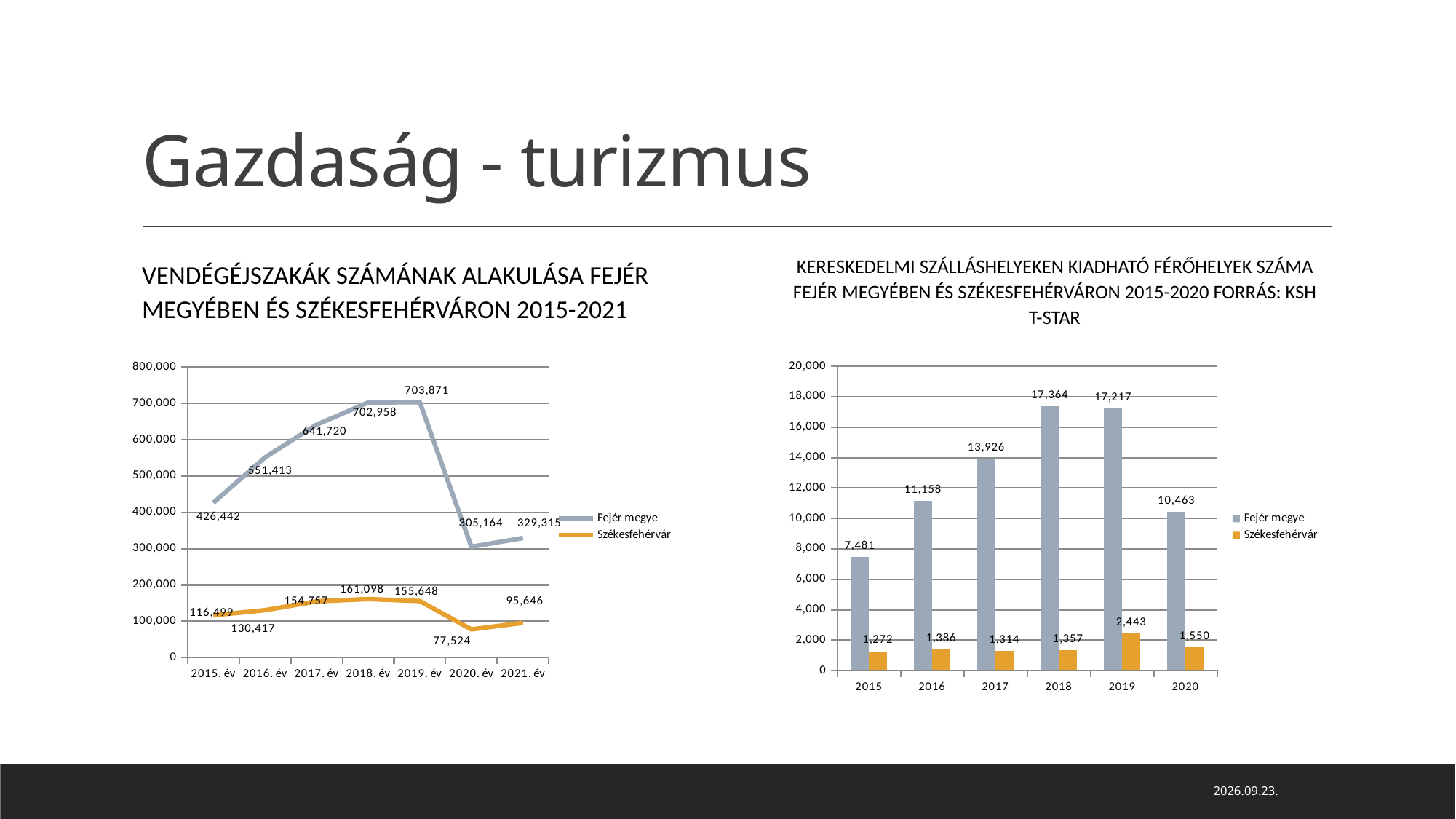
In the right chart (Kereskedelmi szálláshelyeken kiadható férőhelyek száma), what is the difference between the Székesfehérvár values for 2019 and 2018? 1,086 In the right chart (Kereskedelmi szálláshelyeken kiadható férőhelyek száma), what is the Fejér megye value for 2018? 17,364 What kind of chart is the right chart (Kereskedelmi szálláshelyeken kiadható férőhelyek száma)? Bar chart In the left chart (Vendégéjszakák számának alakulása), in which year is the Székesfehérvár value highest? 2018. év What kind of chart is the left chart (Vendégéjszakák számának alakulása)? Line chart In the left chart (Vendégéjszakák számának alakulása), what is the difference between the Fejér megye values for 2019. év and 2020. év? 398,707 In the left chart (Vendégéjszakák számának alakulása), how many years are shown on the x axis? 7 In the left chart (Vendégéjszakák számának alakulása), what is the Fejér megye value for 2019. év? 703,871 In the right chart (Kereskedelmi szálláshelyeken kiadható férőhelyek száma), which is larger for Fejér megye: the 2018 value or the 2019 value? 2018 In the left chart (Vendégéjszakák számának alakulása), what is the Székesfehérvár value for 2020. év? 77,524 In the right chart (Kereskedelmi szálláshelyeken kiadható férőhelyek száma), in which year is the Székesfehérvár value highest? 2019 In the left chart (Vendégéjszakák számának alakulása), in which year is the Fejér megye value lowest? 2020. év